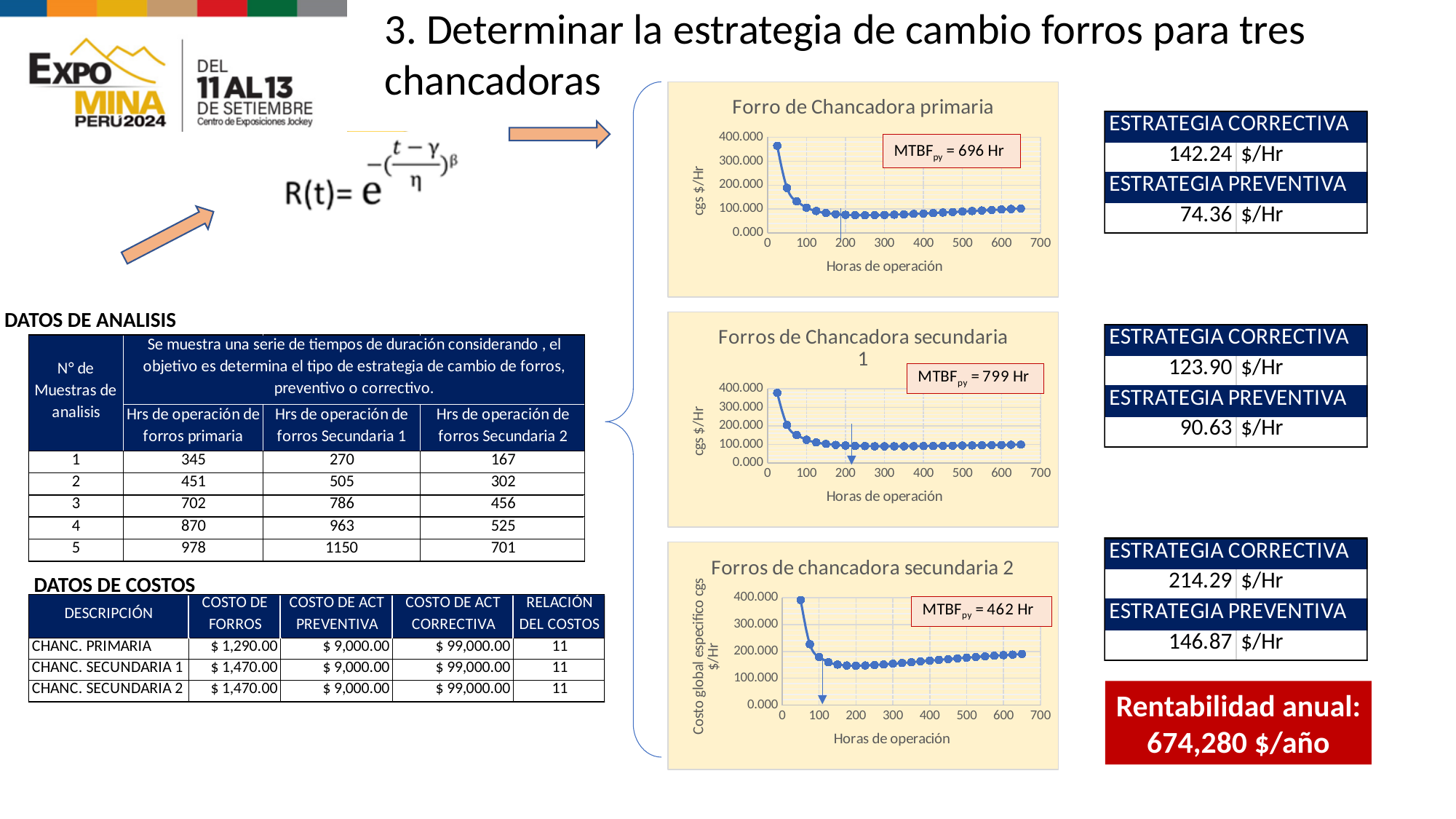
In the 'Forros de chancadora secundaria 2' chart, is the value at 600 hours of operation greater or less than 100.000? greater In the 'Forros de chancadora secundaria 2' chart, is the first plotted value greater or less than 300.000? greater What MTBF value is annotated on the 'Forros de Chancadora secundaria 1' chart? 799 Hr What kind of chart is the 'Forro de Chancadora primaria' chart? line chart In the 'Forro de Chancadora primaria' chart, is the first plotted value greater or less than 300.000? greater What is the x-axis label of the 'Forro de Chancadora primaria' chart? Horas de operación In the 'Forros de chancadora secundaria 2' chart, do the values rise or fall between 300 and 650 hours of operation? rise In the 'Forro de Chancadora primaria' chart, do the values rise or fall between 0 and 200 hours of operation? fall How many charts are shown on the slide? 3